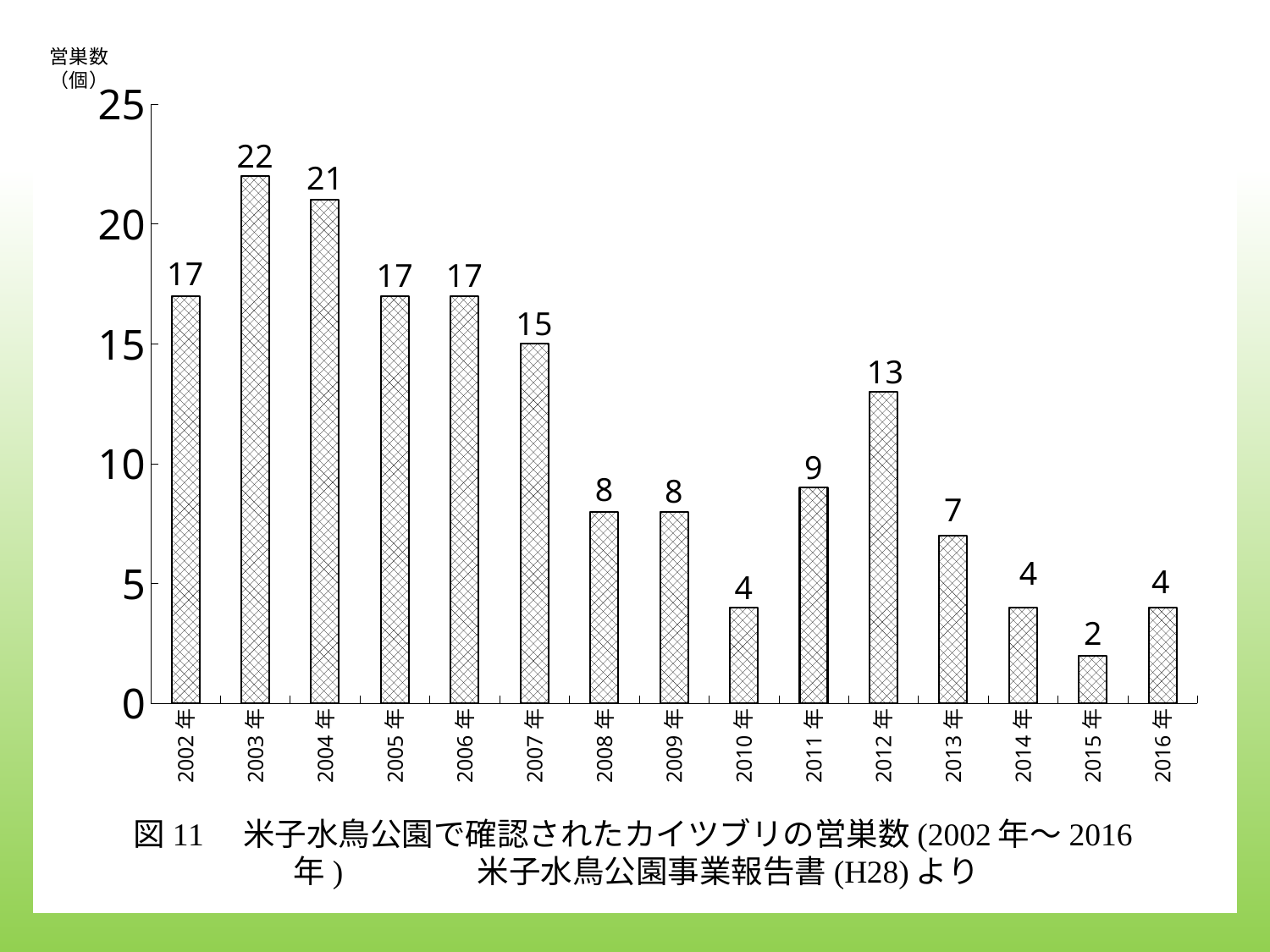
What is the number of nests recorded for 2012年? 13 Which year has the highest number of nests? 2003年 What kind of chart is shown on the slide? Bar chart What is the unit shown on the y-axis label? 営巣数（個） Overall, do the number of nests rise or fall from 2003年 to 2016年? Fall What is the number of nests recorded for 2015年? 2 What is the figure number given in the caption below the chart? 図 11 Which year has the lowest number of nests? 2015年 Which year has more nests, 2011年 or 2013年? 2011年 How many years (bars) are shown in the chart? 15 What is the difference in the number of nests between 2004年 and 2010年? 17 What is the number of nests (営巣数) recorded for 2003年? 22